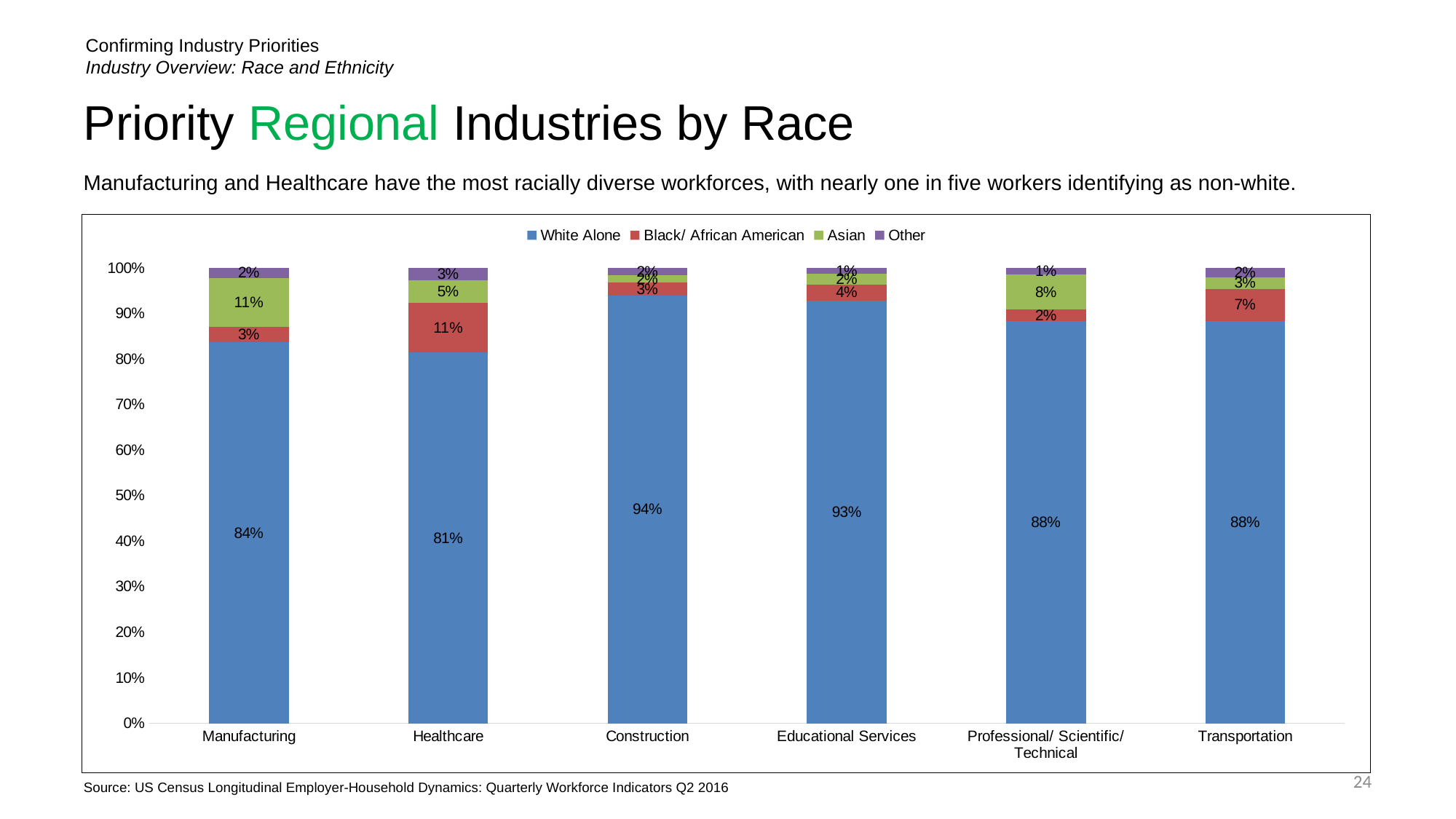
What is the Black/ African American share for Healthcare? 11% What is the Other share for Healthcare? 3% How many industries are shown on the x axis? 6 What is the Asian share for Professional/ Scientific/ Technical? 8% What colour represents the Asian series in the chart? Green What is the White Alone share for Construction? 94% Which has a larger Asian share, Manufacturing or Healthcare? Manufacturing Which industry has the lowest White Alone share? Healthcare What is the difference between the White Alone share for Construction and for Healthcare? 13 percentage points What kind of chart is shown on the slide? Stacked bar chart How many series does the legend list? 4 Which industry has the highest White Alone share? Construction